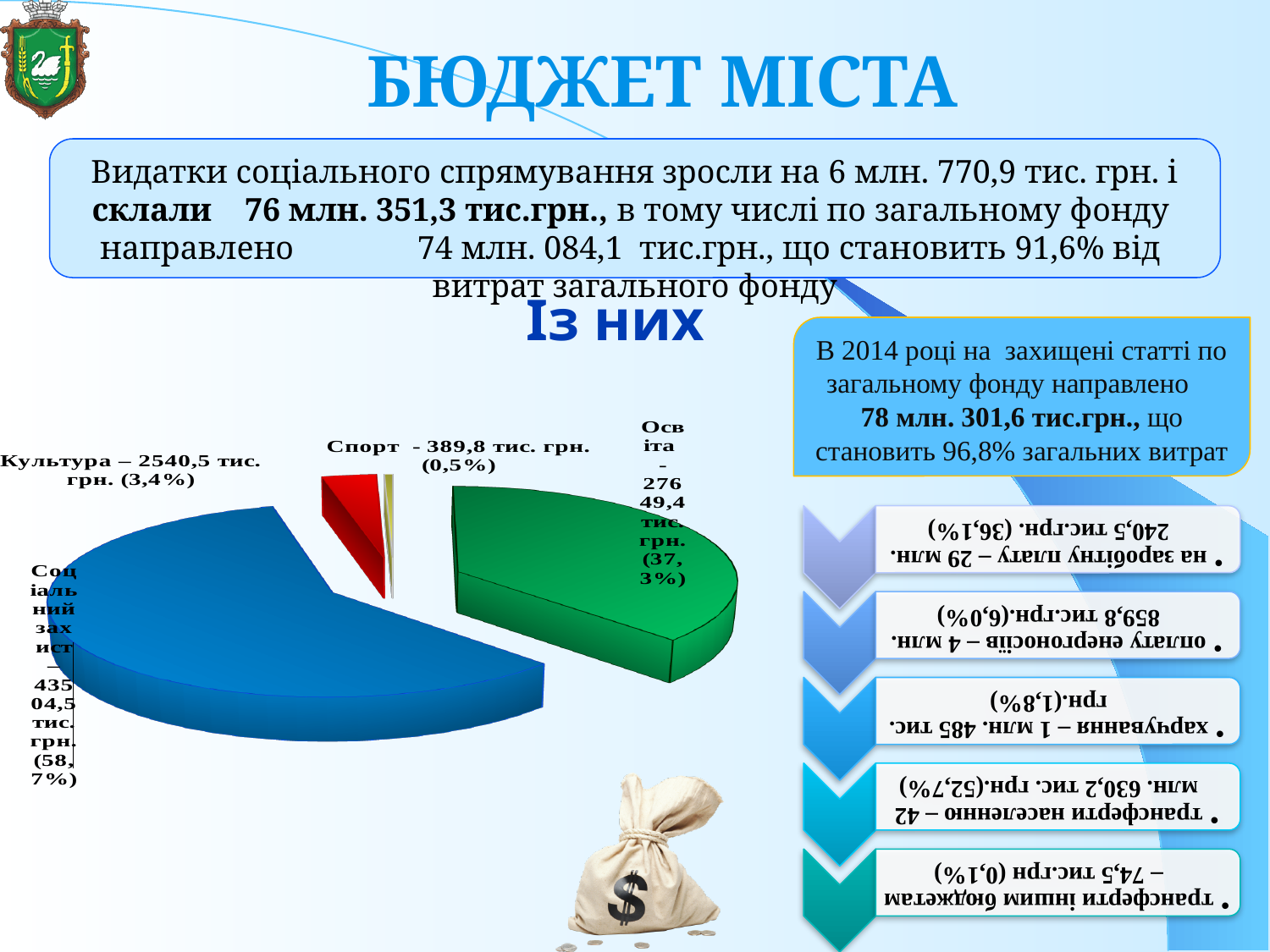
Which category has the smallest slice in the pie chart? Спорт Which is larger in the pie chart, Освіта or Культура? Освіта What percentage share does Соціальний захист have in the pie chart? 58,7% What percentage share does Освіта have in the pie chart? 37,3% What is the difference in percentage points between the Соціальний захист and Освіта slices? 21,4 What colour is the Освіта slice in the pie chart? green What kind of chart is shown on the slide? pie chart How many slices does the pie chart have? 4 What value is shown for Спорт in the pie chart? 389,8 тис. грн. (0,5%) Which category has the largest slice in the pie chart? Соціальний захист What value is shown for Культура in the pie chart? 2540,5 тис. грн. (3,4%) What colour is the Соціальний захист slice in the pie chart? blue